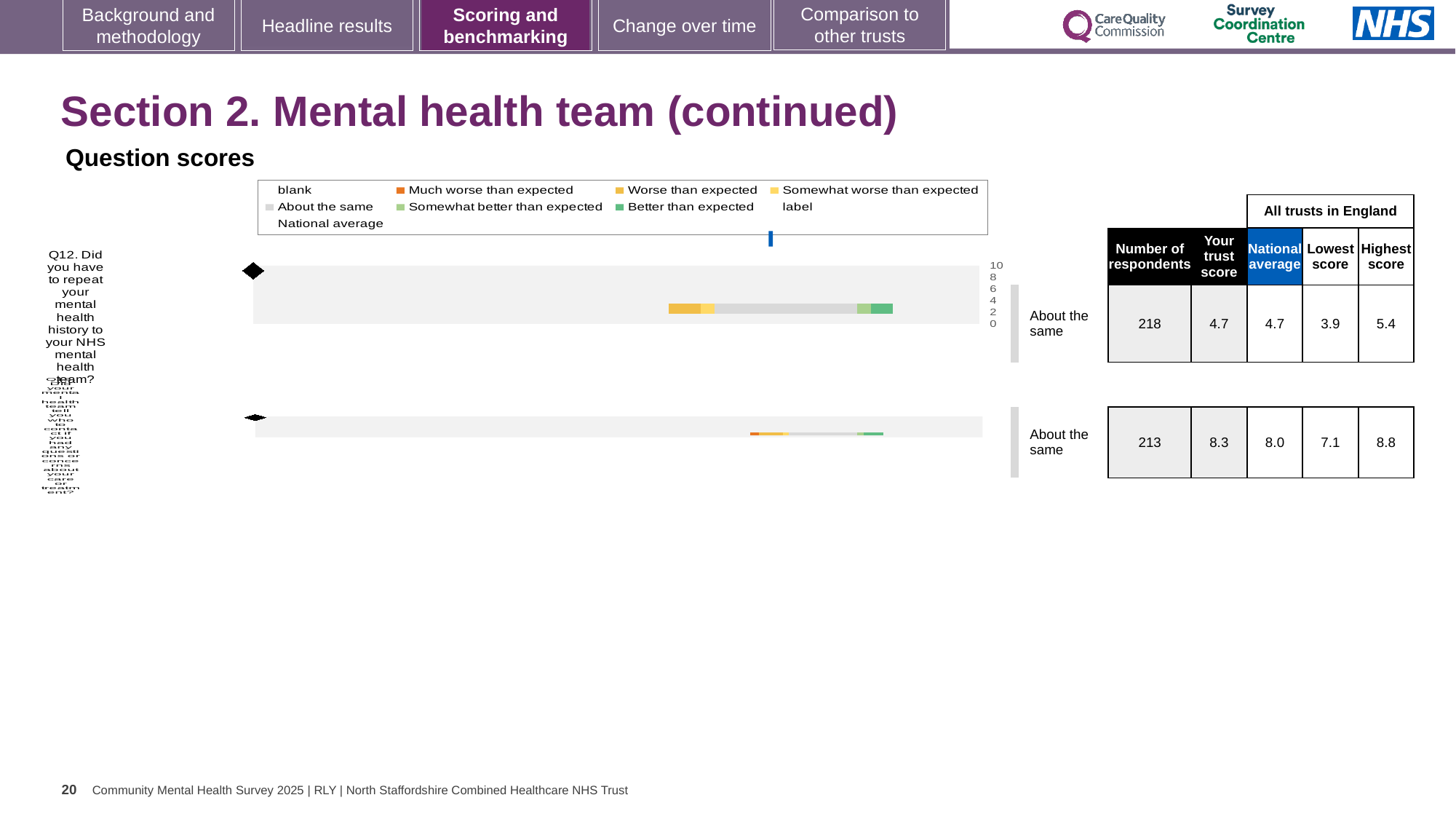
What is the difference between the highest and lowest scores for Q12 across all trusts in England? 1.5 What is the trust score for Q12 (repeating your mental health history to your NHS mental health team)? 4.7 In the chart legend, what colour represents 'Better than expected'? green What is the lowest score among all trusts in England for Q12? 3.9 How many respondents answered Q12? 218 For the second (lower) question on the slide, what is the trust score? 8.3 What is the highest score among all trusts in England for Q12? 5.4 For the second (lower) question on the slide, which is larger: the trust score or the national average? trust score What is the national average for Q12? 4.7 What kind of chart is used to show the question scores on this slide? bar chart For the second (lower) question on the slide, what is the difference between the trust score and the national average? 0.3 How many questions (rows) are plotted in the question scores chart? 2